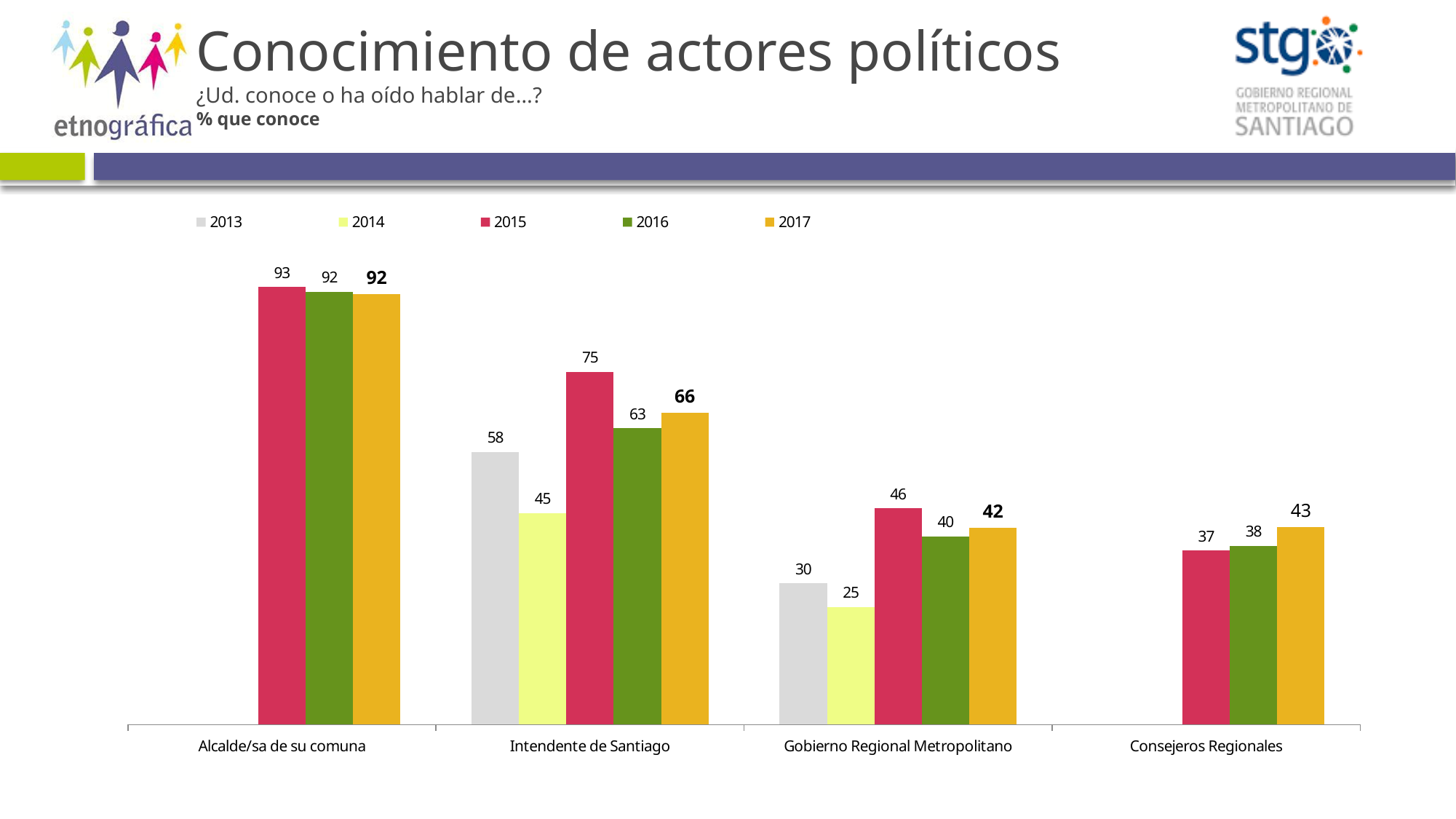
Which is larger for Gobierno Regional Metropolitano: the 2013 value or the 2017 value? 2017 What is the 2014 value for Gobierno Regional Metropolitano? 25 What is the 2015 value for Alcalde/sa de su comuna? 93 Which year has the lowest value for Intendente de Santiago? 2014 Which years are listed in the legend? 2013, 2014, 2015, 2016, 2017 What is the difference between the 2015 and 2016 values for Intendente de Santiago? 12 How many series does the legend list? 5 Which category has the highest 2017 value? Alcalde/sa de su comuna What is the 2016 value for Consejeros Regionales? 38 What is the 2017 value for Intendente de Santiago? 66 How many categories are shown on the x axis? 4 What kind of chart is shown on the slide? Bar chart